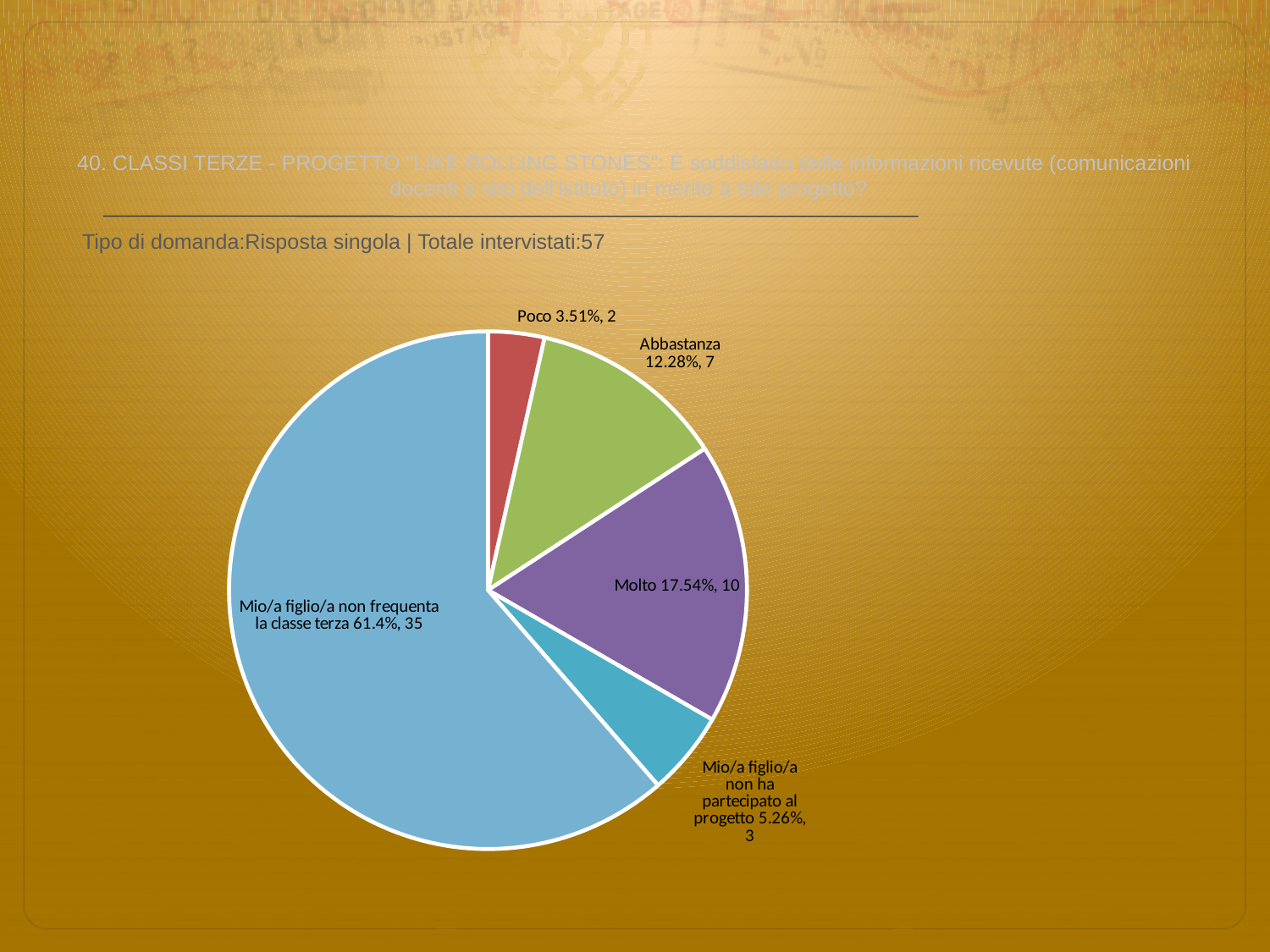
Which category has the smallest slice of the pie? Poco What share of the pie does 'Mio/a figlio/a non ha partecipato al progetto' represent? 5.26% How many respondents are in the 'Mio/a figlio/a non frequenta la classe terza' slice? 35 What percentage is shown for 'Poco'? 3.51% What is the difference in respondent count between 'Molto' and 'Abbastanza'? 3 How many slices does the pie chart have? 5 Which has more respondents, 'Mio/a figlio/a non ha partecipato al progetto' or 'Poco'? Mio/a figlio/a non ha partecipato al progetto What percentage is shown for the 'Molto' slice? 17.54% What is the total number of respondents stated on the slide? 57 Which category has the largest slice of the pie? Mio/a figlio/a non frequenta la classe terza What kind of chart is shown on the slide? pie chart How many respondents answered 'Abbastanza'? 7